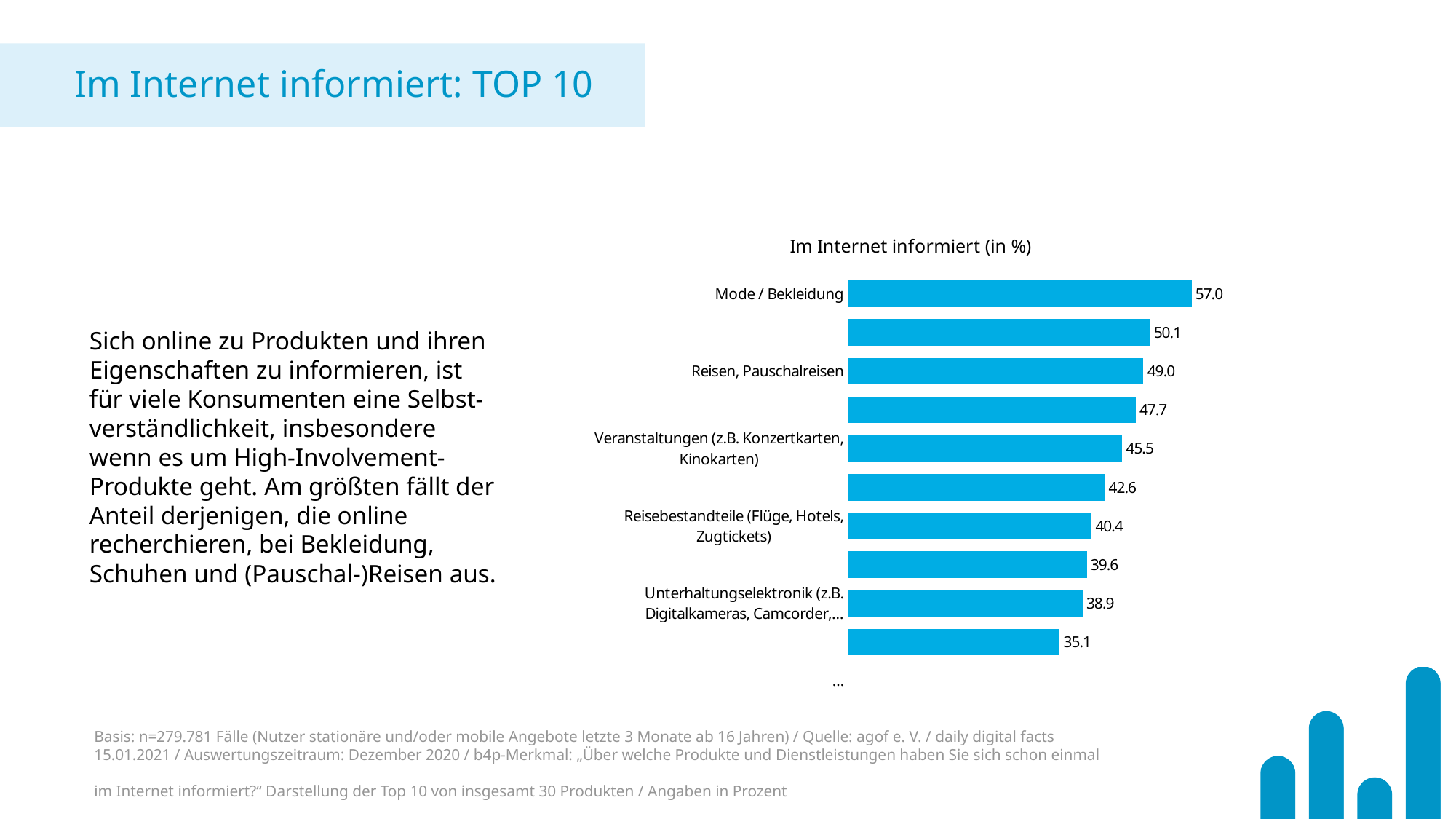
What kind of chart is shown on the slide? Bar chart What value is shown for Reisebestandteile (Flüge, Hotels, Zugtickets)? 40.4 What value is shown for Reisen, Pauschalreisen? 49.0 Which is larger: the value for Reisen, Pauschalreisen or the value for Unterhaltungselektronik (z.B. Digitalkameras, Camcorder,...)? Reisen, Pauschalreisen How many bars with data labels are plotted in the chart? 10 What is the title of the chart? Im Internet informiert (in %) What value is shown for Unterhaltungselektronik (z.B. Digitalkameras, Camcorder,...)? 38.9 What value is shown for Veranstaltungen (z.B. Konzertkarten, Kinokarten)? 45.5 What is the difference between the values for Mode / Bekleidung and Reisen, Pauschalreisen? 8.0 What is the difference between the values for Veranstaltungen (z.B. Konzertkarten, Kinokarten) and Reisebestandteile (Flüge, Hotels, Zugtickets)? 5.1 What value is shown for Mode / Bekleidung in the chart? 57.0 Which labelled category has the highest value in the chart? Mode / Bekleidung